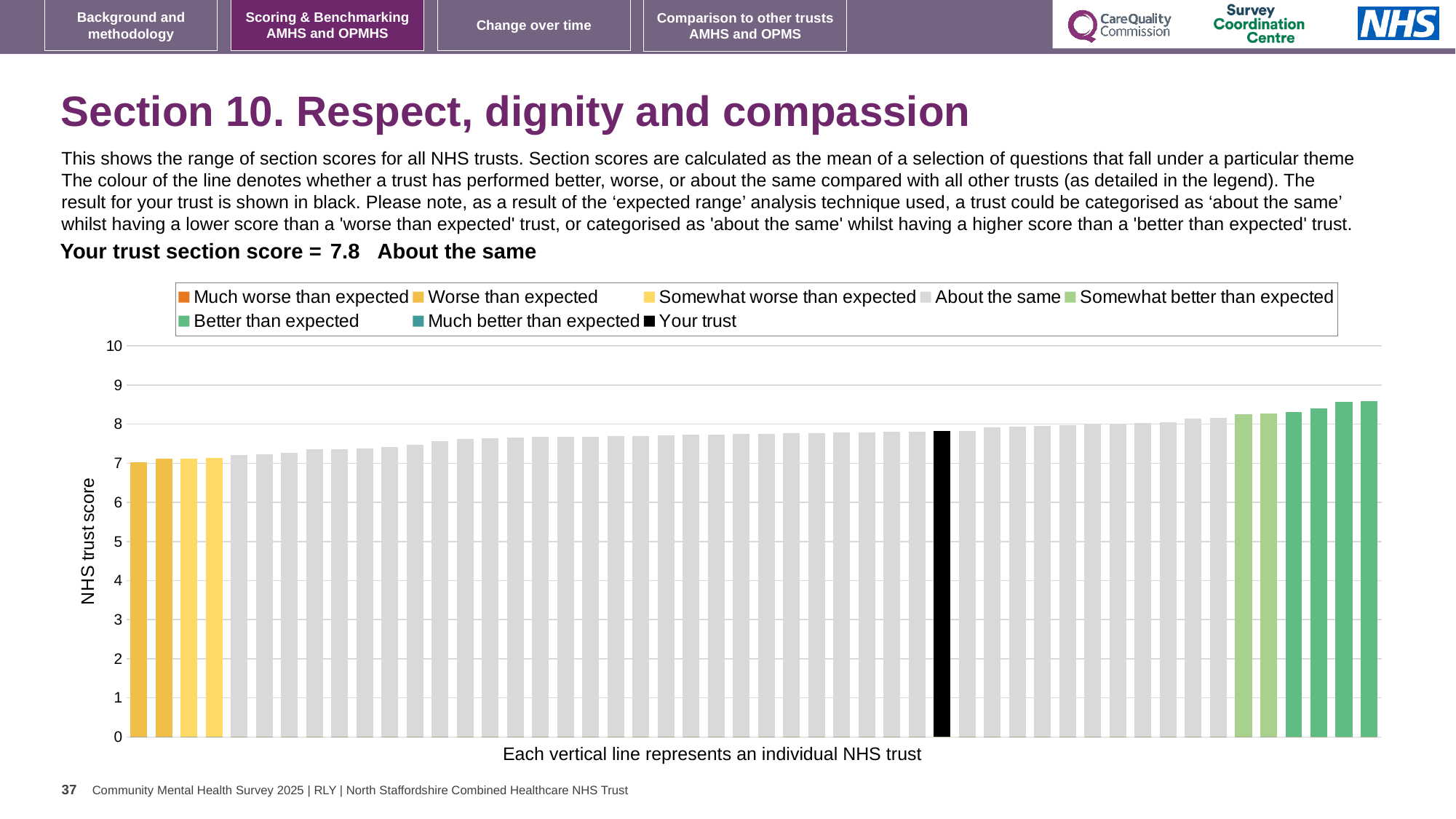
What is the label on the vertical axis of the chart? NHS trust score Which category is your trust placed in for this section? About the same What is the section score for your trust shown on the slide? 7.8 What colour is the bar representing your trust? black Is the value of the rightmost (highest) bar greater or less than 8? greater How many entries does the chart legend list? 8 What kind of chart is shown on the slide? bar chart Is the value of the black 'Your trust' bar greater or less than 8? less Do the bar values rise or fall from left to right along the x axis? rise Is the value of the leftmost (lowest) bar greater or less than 8? less